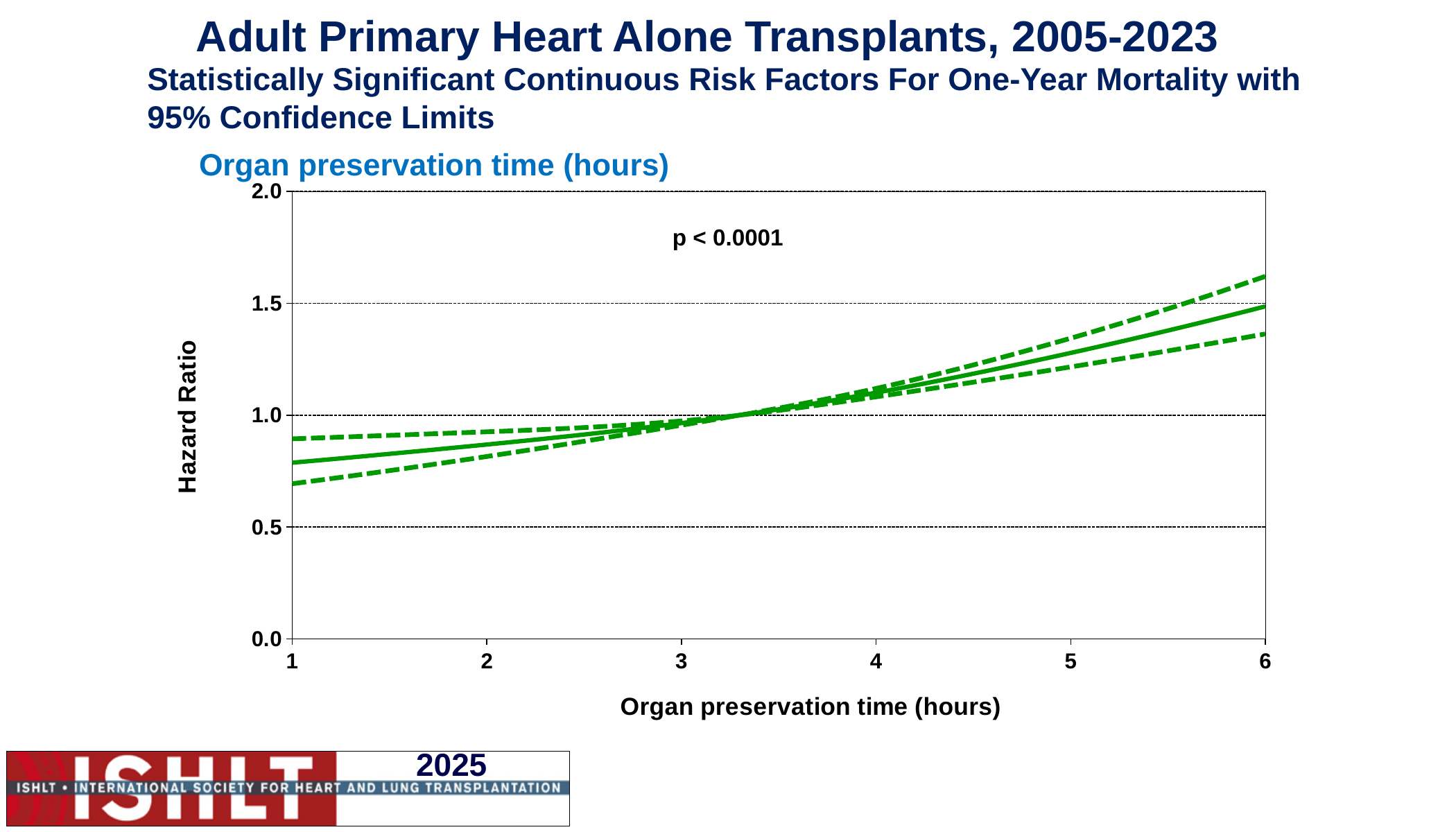
What is the label of the y axis? Hazard Ratio Is the hazard ratio (solid line) at 6 hours of organ preservation time greater or less than 1.0? greater What kind of chart is shown on the slide? line chart What p-value is printed on the chart? p < 0.0001 At which organ preservation time shown on the x axis is the hazard ratio highest? 6 hours Does the hazard ratio rise or fall as organ preservation time increases from 1 to 6 hours? rise Is the upper 95% confidence limit at 6 hours of organ preservation time greater or less than 1.5? greater Is the lower 95% confidence limit at 1 hour of organ preservation time greater or less than 0.5? greater Which has the larger hazard ratio: an organ preservation time of 1 hour or 6 hours? 6 hours How many lines are plotted on the chart (including the confidence limits)? 3 At which organ preservation time shown on the x axis is the hazard ratio lowest? 1 hour